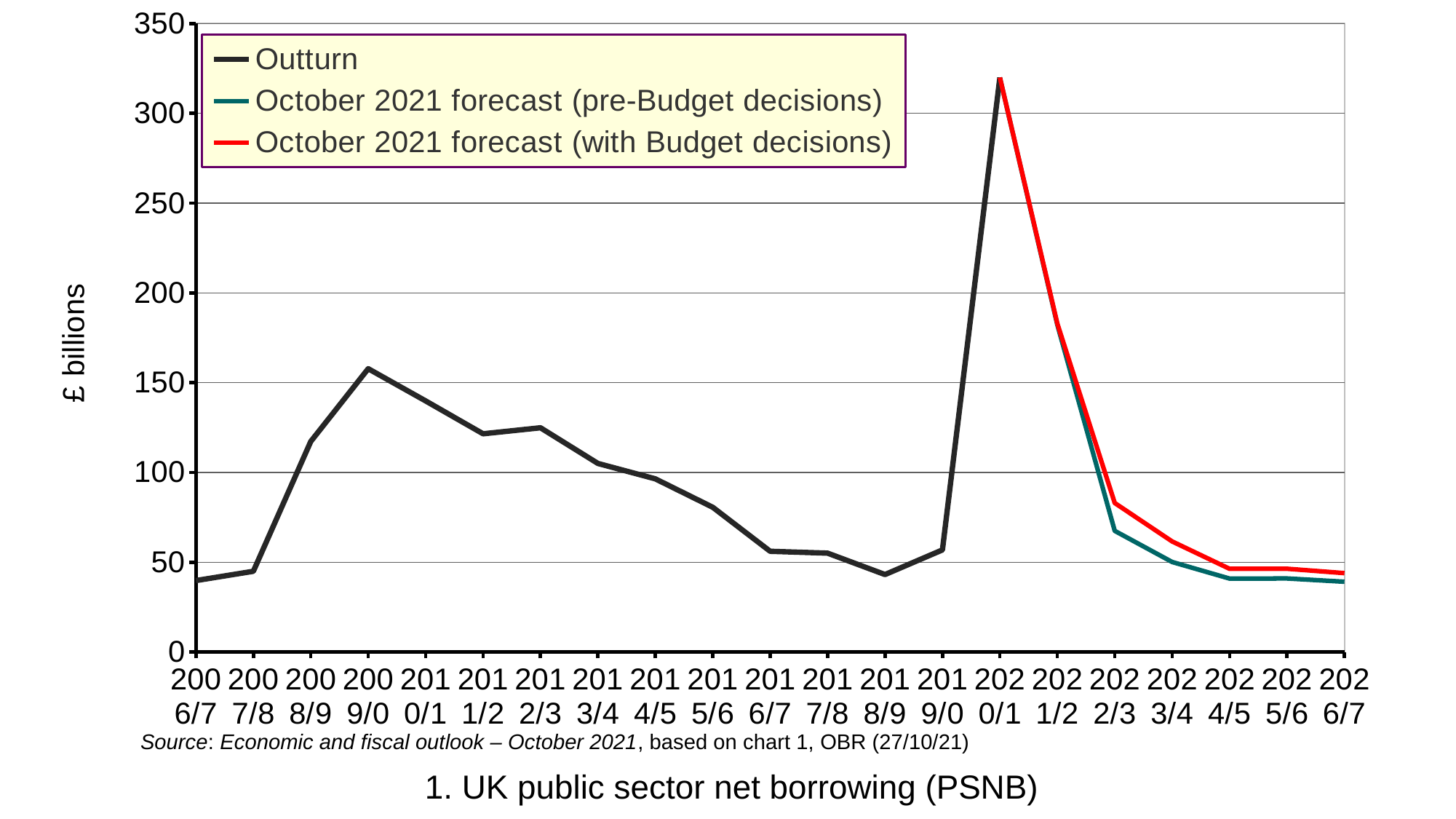
Is the Outturn value for 2018/9 greater or less than 50? less What kind of chart is shown on the slide? line chart What is the label on the y axis? £ billions Is the Outturn value for 2020/1 greater or less than 300? greater In which year does the Outturn series reach its highest value? 2020/1 Which is larger for 2022/3: the October 2021 forecast (pre-Budget decisions) or the October 2021 forecast (with Budget decisions)? October 2021 forecast (with Budget decisions) Which is larger for the Outturn series: the value for 2009/0 or the value for 2012/3? 2009/0 Is the October 2021 forecast (with Budget decisions) value for 2022/3 greater or less than 100? less How many series does the legend list? 3 Do the forecast series rise or fall from 2020/1 to 2026/7? fall How many fiscal years are plotted along the x axis? 21